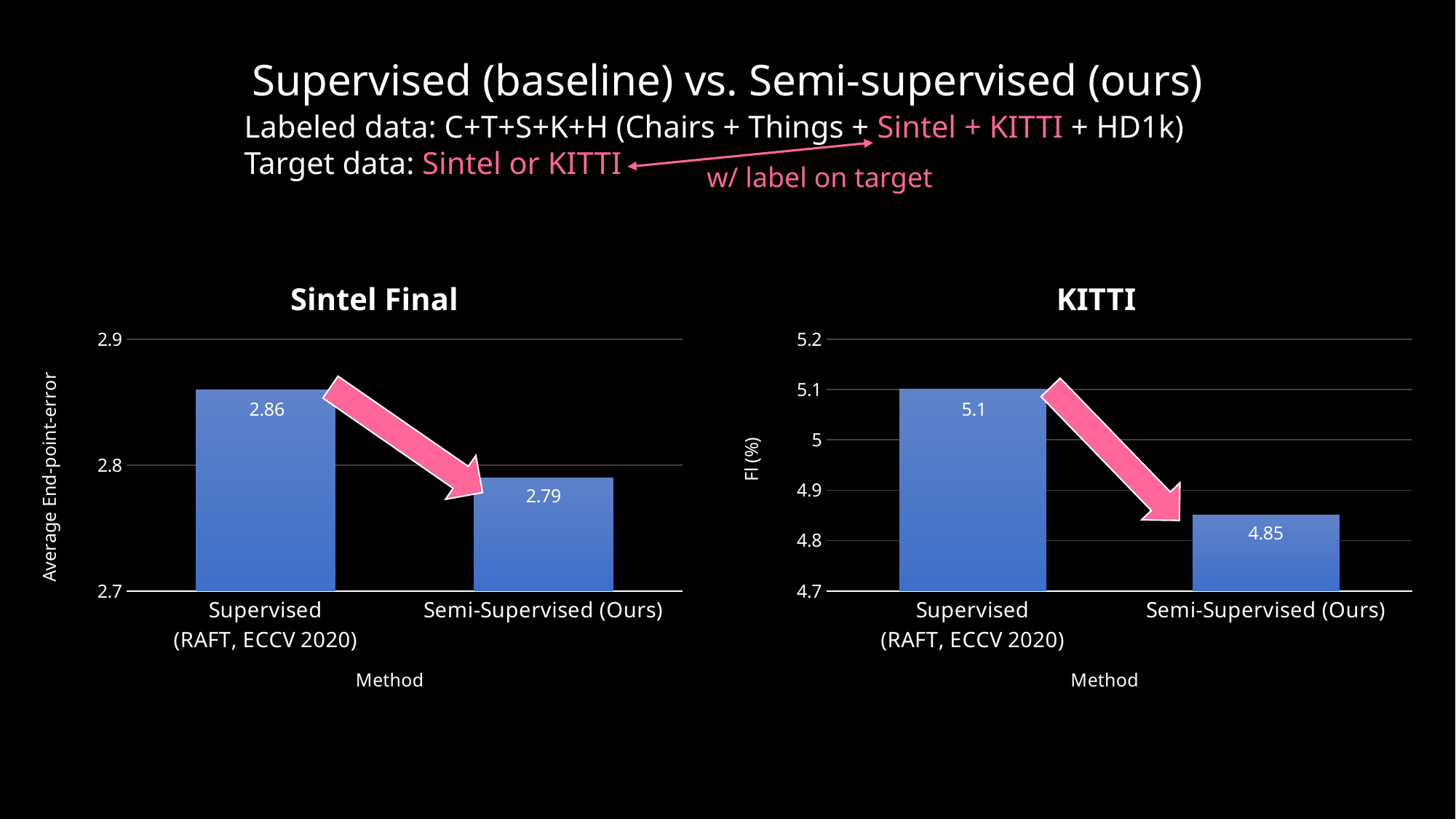
What kind of chart is the KITTI chart? bar chart What is the y-axis label of the Sintel Final chart? Average End-point-error How many bars are shown in the Sintel Final chart? 2 In the KITTI chart, what is the value for Semi-Supervised (Ours)? 4.85 In the Sintel Final chart, which method has the lowest average end-point-error? Semi-Supervised (Ours) In the KITTI chart, which method has the highest Fl (%)? Supervised (RAFT, ECCV 2020) In the Sintel Final chart, what is the value for Semi-Supervised (Ours)? 2.79 In the KITTI chart, what is the value for Supervised (RAFT, ECCV 2020)? 5.1 In the Sintel Final chart, what is the difference between the Supervised and Semi-Supervised values? 0.07 In the KITTI chart, is the value for Semi-Supervised (Ours) greater or less than 5? less In the Sintel Final chart, what is the value for Supervised (RAFT, ECCV 2020)? 2.86 In the KITTI chart, what is the difference between the Supervised and Semi-Supervised values? 0.25